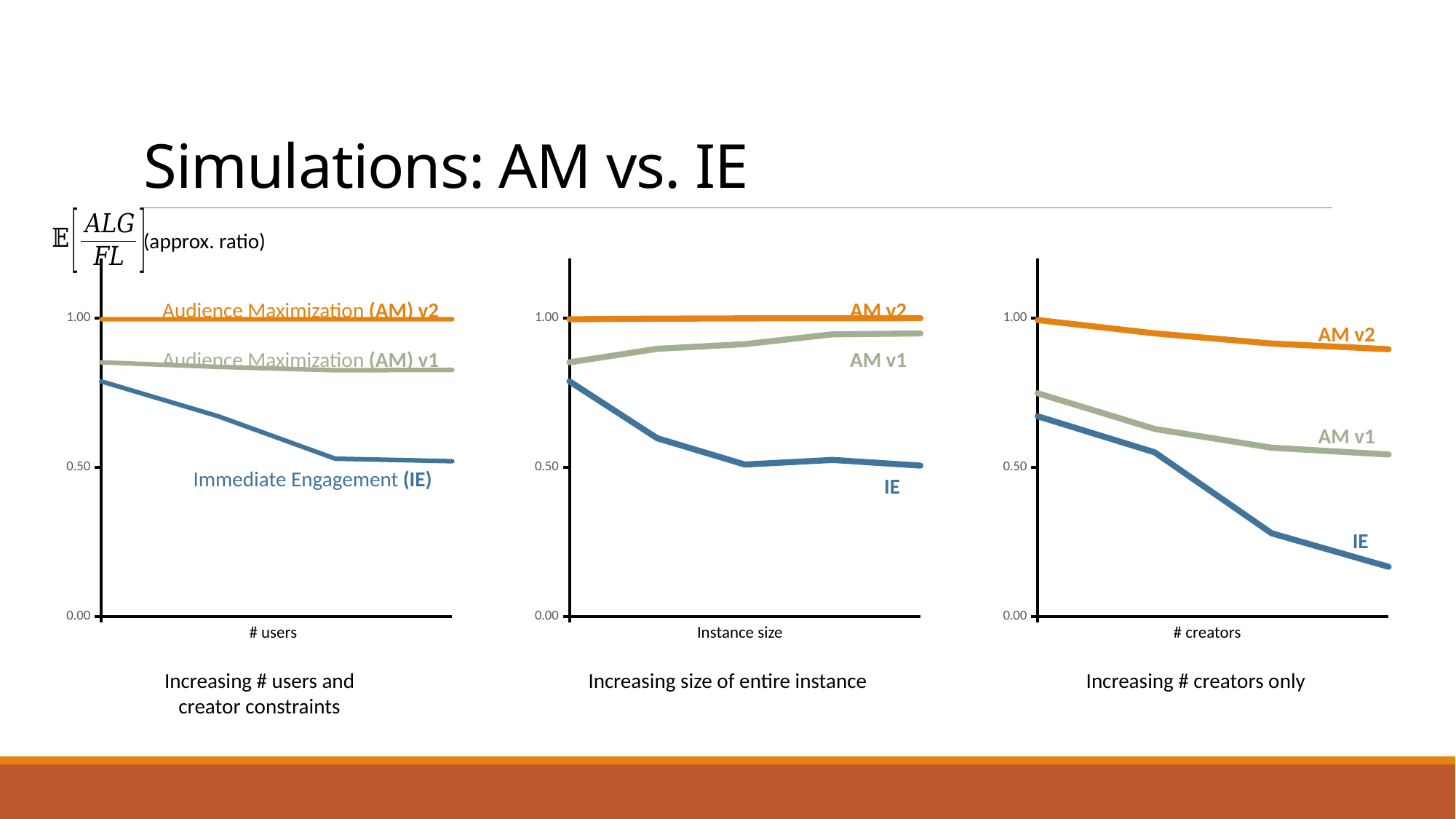
In the left chart (x axis '# users'), is the first value of the Immediate Engagement (IE) line greater or less than 0.50? greater In the left chart (x axis '# users'), which series has the highest values? Audience Maximization (AM) v2 In the right chart (x axis '# creators'), is the final value of the AM v2 line greater or less than 0.50? greater In the right chart (x axis '# creators'), is the final value of the IE line greater or less than 0.50? less In the right chart (x axis '# creators'), which series has the lowest values? IE In the middle chart (x axis 'Instance size'), does the AM v1 line rise or fall as instance size increases? rises How many series are plotted in the middle chart (x axis 'Instance size')? 3 What is the x-axis label of the middle chart? Instance size In the right chart (x axis '# creators'), which series is larger at the right end of the x axis, AM v2 or IE? AM v2 What kind of chart is the left chart (x axis '# users')? line chart In the right chart (x axis '# creators'), does the IE line rise or fall as the number of creators increases? falls In the middle chart (x axis 'Instance size'), does the IE line rise or fall as instance size increases? falls